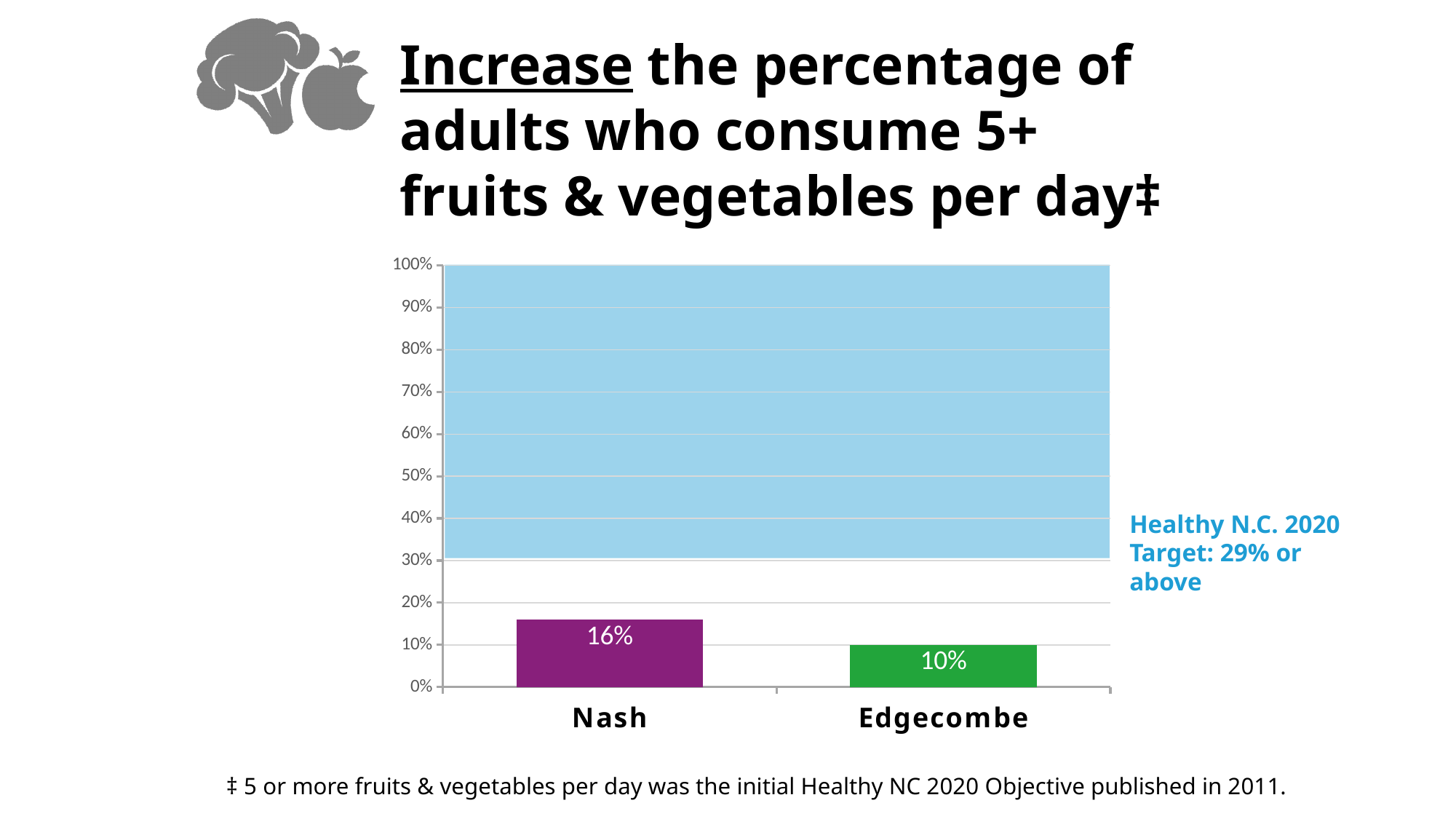
How many counties are shown on the chart? 2 Is the value for Nash larger or smaller than the value for Edgecombe? larger Which county has the lower value? Edgecombe Which county has the higher value? Nash What colour is the bar for Edgecombe? green Is the value for Edgecombe greater or less than 30%? less What is the Healthy N.C. 2020 target shown next to the chart? 29% or above What is the value for Edgecombe? 10% What is the value for Nash? 16% Is the value for Nash greater or less than 20%? less What is the difference between the values for Nash and Edgecombe? 6% What kind of chart is shown on the slide? bar chart